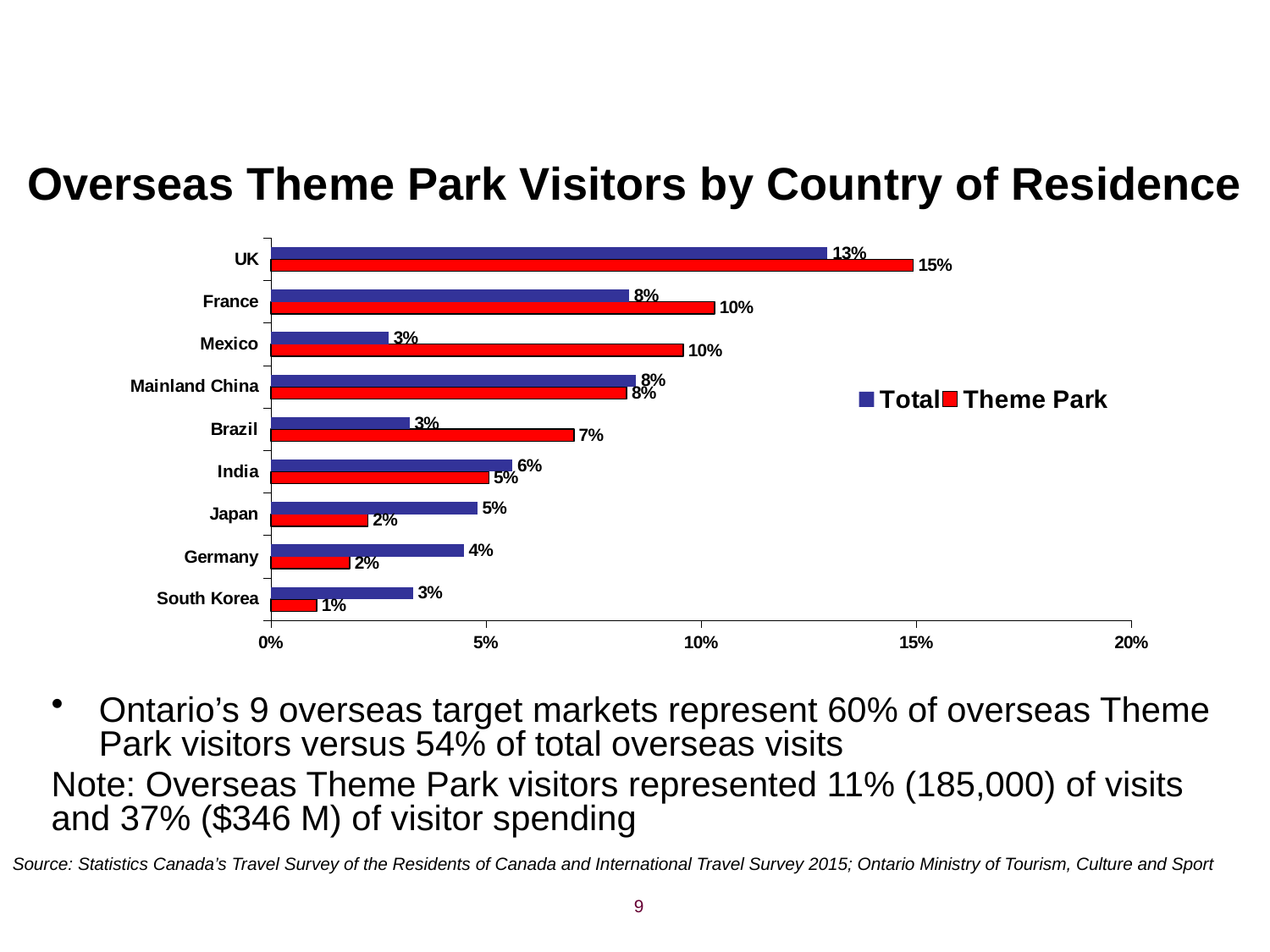
What is the Theme Park value for the UK? 15% What colour are the Theme Park bars? Red What is the Theme Park value for Brazil? 7% What is the Total value for Mexico? 3% How many countries are shown on the chart? 9 Which country has the lowest Theme Park value? South Korea Which country has the highest Theme Park value? UK Which is larger for Japan, the Total value or the Theme Park value? Total How many series does the legend list? 2 What is the difference between the Theme Park and Total values for Mexico? 7% What kind of chart is shown on the slide? Bar chart What is the Total value for Japan? 5%